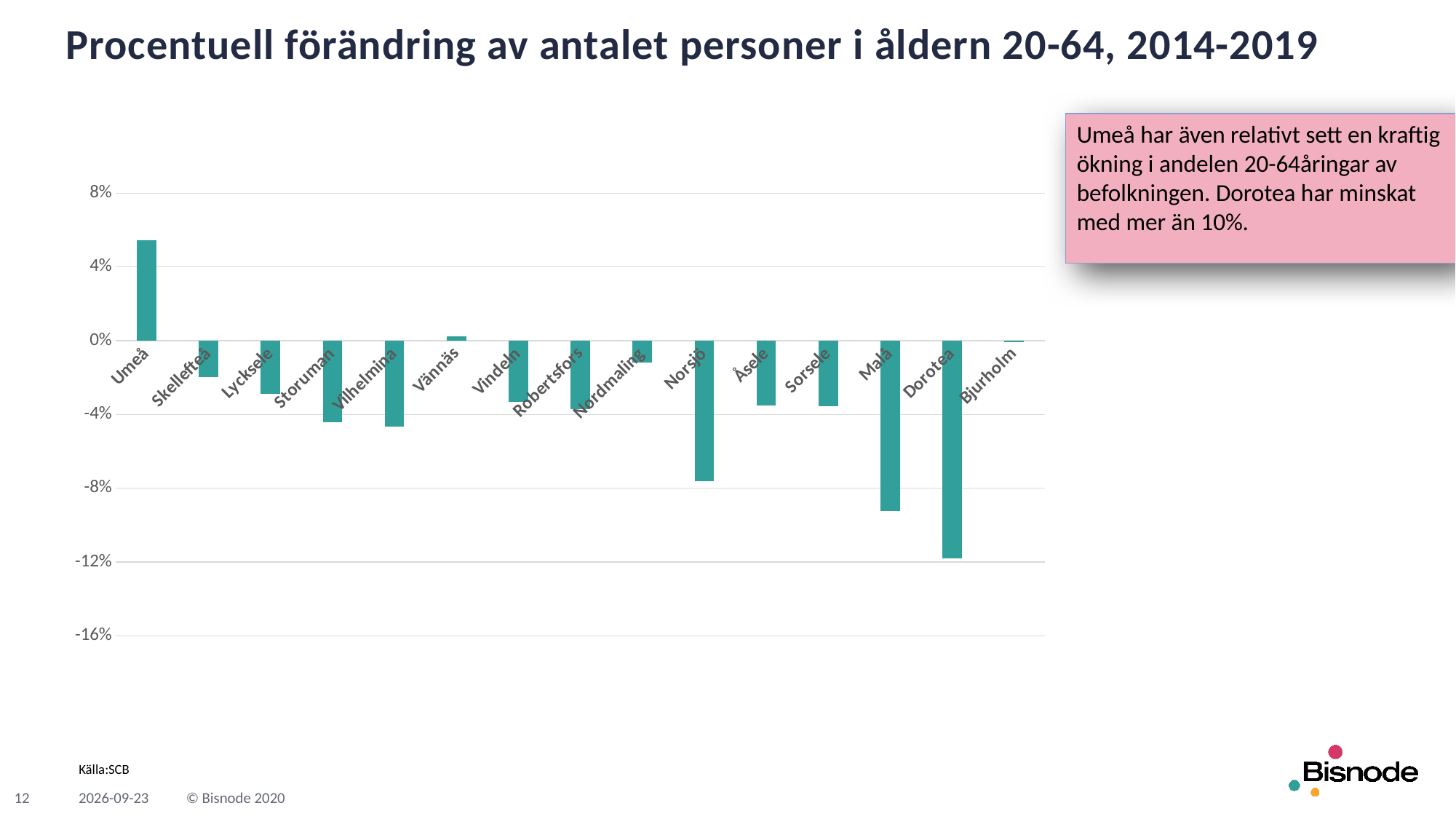
Which has the larger value, Vännäs or Vindeln? Vännäs What kind of chart is shown on the slide? Bar chart Is the value for Nordmaling greater or less than -4%? greater Is the value for Umeå greater or less than 4%? greater Is the value for Norsjö greater or less than -4%? less Which municipality has the highest value in the chart? Umeå Which municipality has the lowest value in the chart? Dorotea How many municipalities are shown on the x axis of the chart? 15 What is the title of the chart on the slide? Procentuell förändring av antalet personer i åldern 20-64, 2014-2019 Which has the larger value, Norsjö or Malå? Norsjö